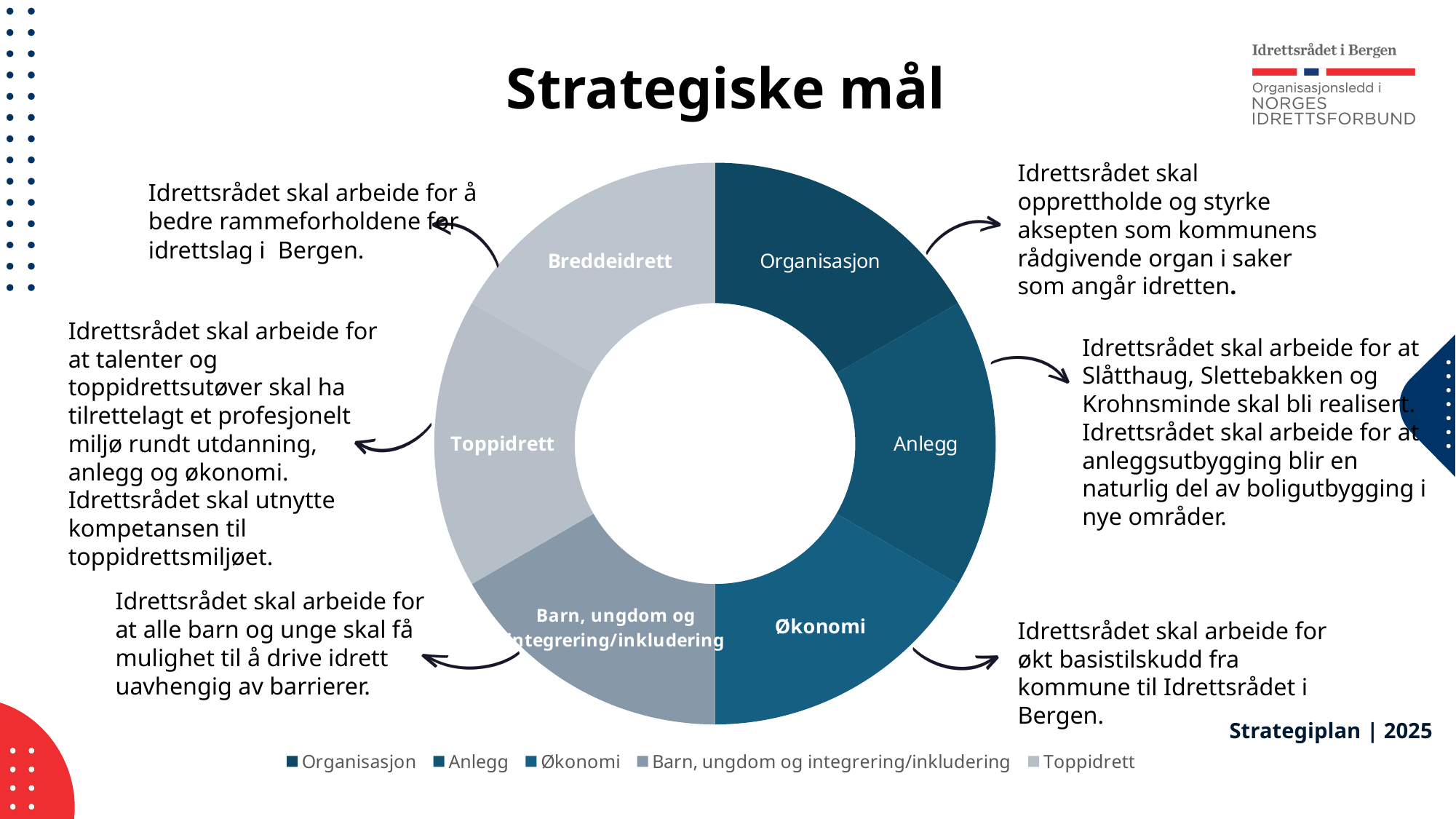
What is the title of the slide containing the doughnut chart? Strategiske mål How many segments does the doughnut chart have? 6 What kind of chart is shown on the slide? Doughnut chart How many entries does the legend below the chart list? 5 Which segment of the doughnut chart is labelled in the top-right position? Organisasjon Which segment of the doughnut chart is labelled 'Økonomi'? The bottom-right segment Which segment label appears in the top-left part of the doughnut chart? Breddeidrett Which segment label in the doughnut chart is not listed in the legend? Breddeidrett